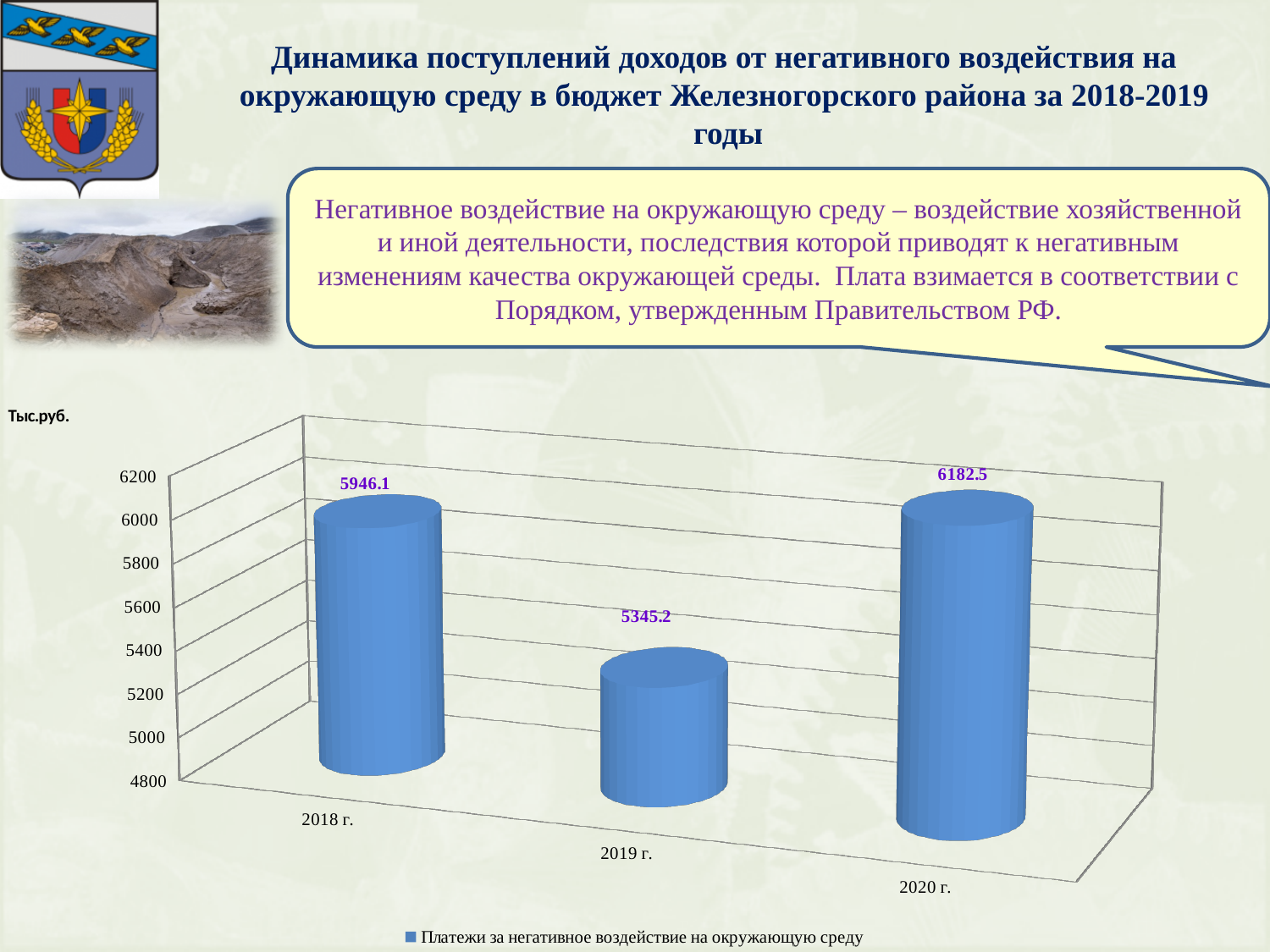
What is the value for 2019 г.? 5345.2 What kind of chart is shown on the slide? bar chart Which year has the lowest value? 2019 г. What is the value for 2018 г.? 5946.1 Which is larger, the value for 2018 г. or the value for 2020 г.? 2020 г. Is the value for 2019 г. greater or less than 5600? less What series name does the legend show? Платежи за негативное воздействие на окружающую среду What is the value for 2020 г.? 6182.5 Which year has the highest value? 2020 г. How many years are shown on the chart? 3 What is the difference between the values for 2020 г. and 2019 г.? 837.3 What is the difference between the values for 2018 г. and 2019 г.? 600.9